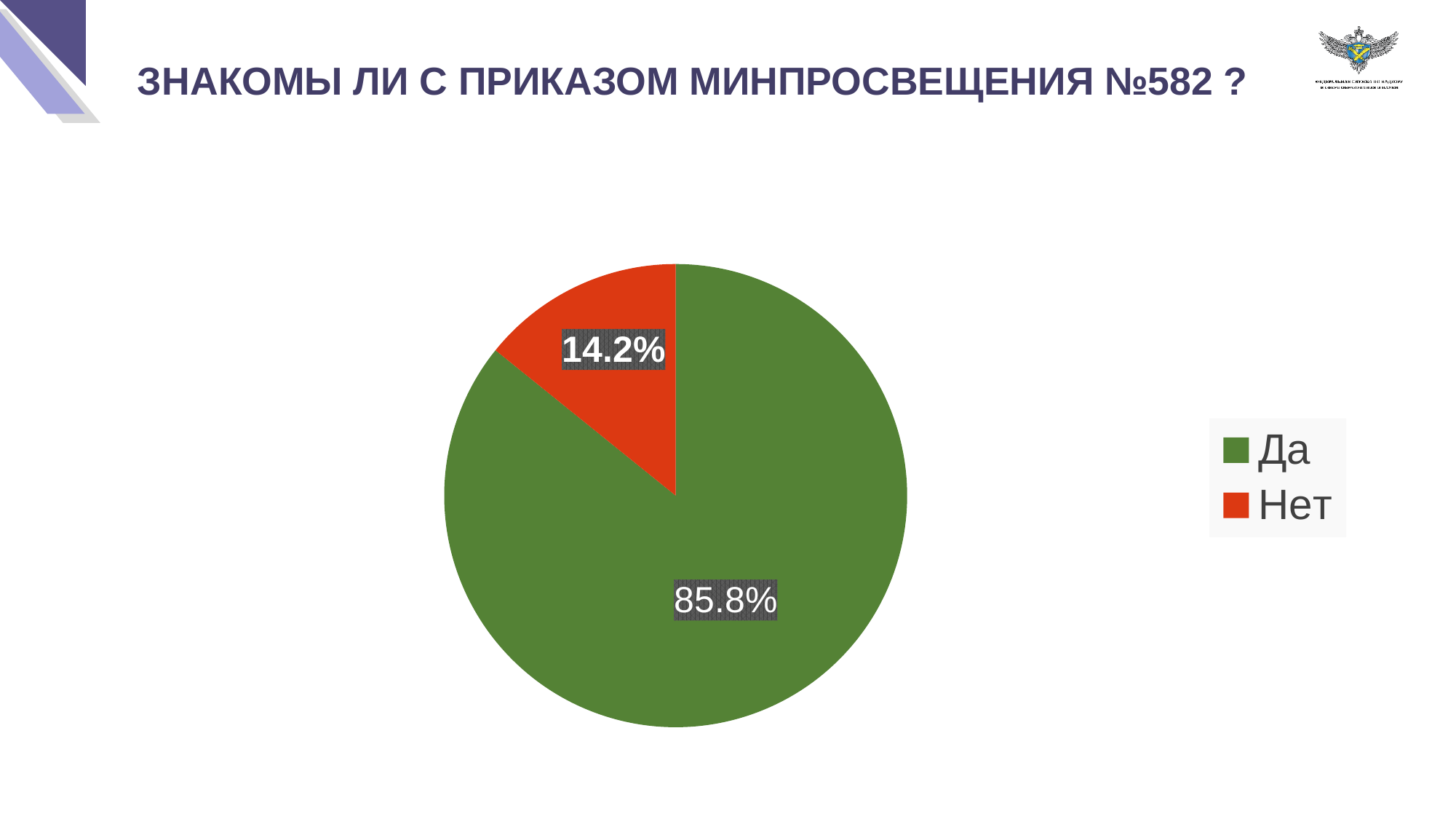
What is the title of the slide above the chart? ЗНАКОМЫ ЛИ С ПРИКАЗОМ МИНПРОСВЕЩЕНИЯ №582 ? What share of the pie does "Да" take? 85.8% How many entries does the legend list? 2 What share of the pie does "Нет" take? 14.2% What is the difference in percentage points between the "Да" and "Нет" slices? 71.6 How many slices does the pie chart have? 2 Which slice of the pie is the smallest? Нет What kind of chart is shown on the slide? pie chart What colour is the "Нет" slice? red Which slice of the pie is the largest? Да Which is larger, the "Да" slice or the "Нет" slice? Да